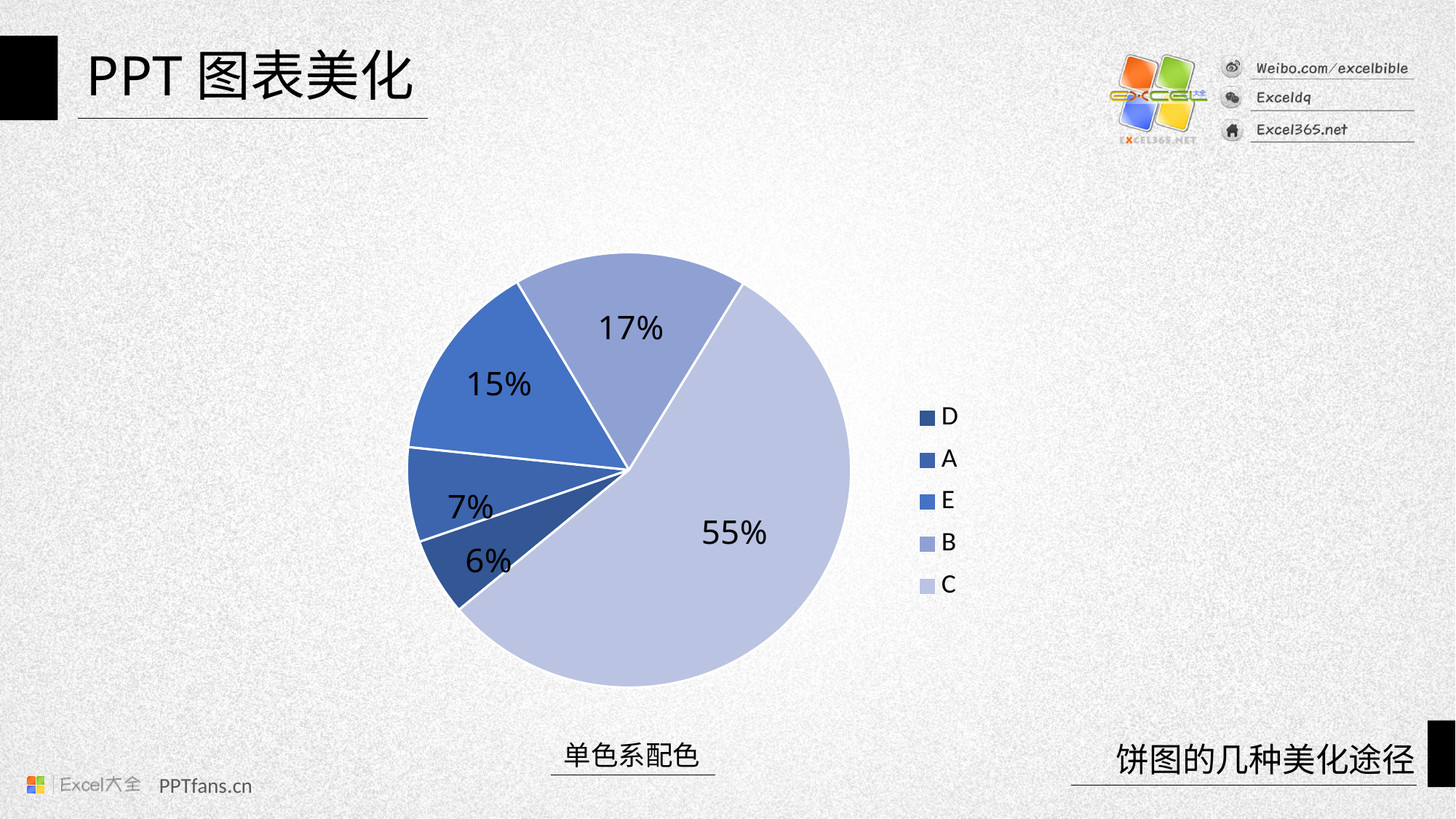
What is the caption shown below the pie chart? 单色系配色 What is the difference between the shares of B and E? 2% What percentage is shown for category C? 55% Which is larger, the share of A or the share of E? E Which category has the largest share of the pie? C What kind of chart is shown on the slide? pie chart How many entries does the legend list? 5 How many slices does the pie chart have? 5 What percentage is shown for category D? 6% Which category has the smallest share of the pie? D What percentage is shown for category E? 15% What percentage is shown for category B? 17%